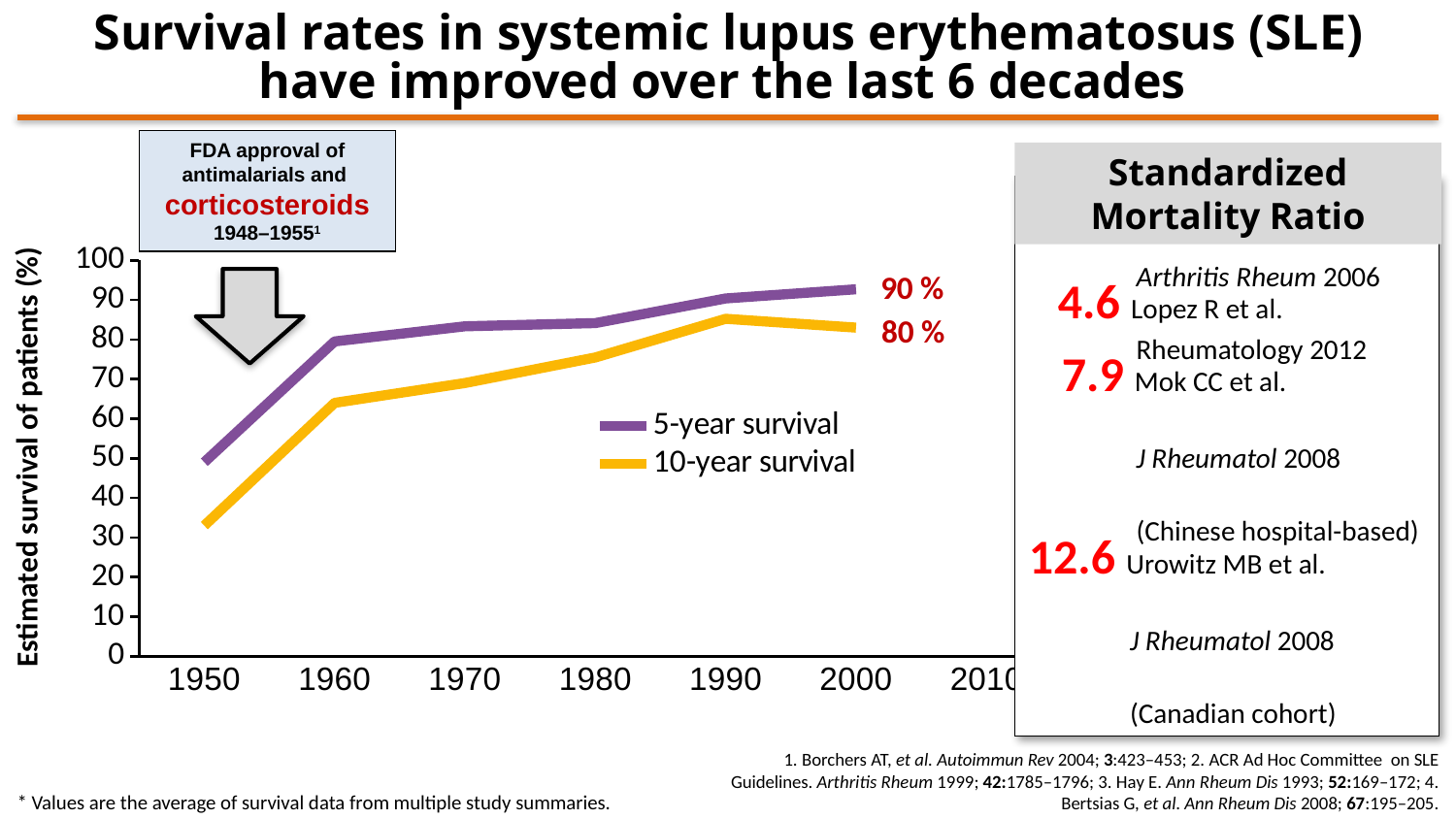
What are the two series named in the chart legend? 5-year survival and 10-year survival How many series does the chart legend list? 2 What is the labelled value for 10-year survival at the end of the line (2000)? 80 % What is the difference between the labelled 5-year survival and 10-year survival values at 2000? 10 % Is the 10-year survival value at 1950 greater or less than 40? less Does the 5-year survival line rise or fall from 1950 to 2000? rise What kind of chart is shown on the slide? line chart Which series has the higher value at 2000, 5-year survival or 10-year survival? 5-year survival What is the labelled value for 5-year survival at the end of the line (2000)? 90 % What is the label of the y axis? Estimated survival of patients (%) Is the 10-year survival value at 1990 greater or less than 80? greater Is the 5-year survival value at 1960 greater or less than 70? greater